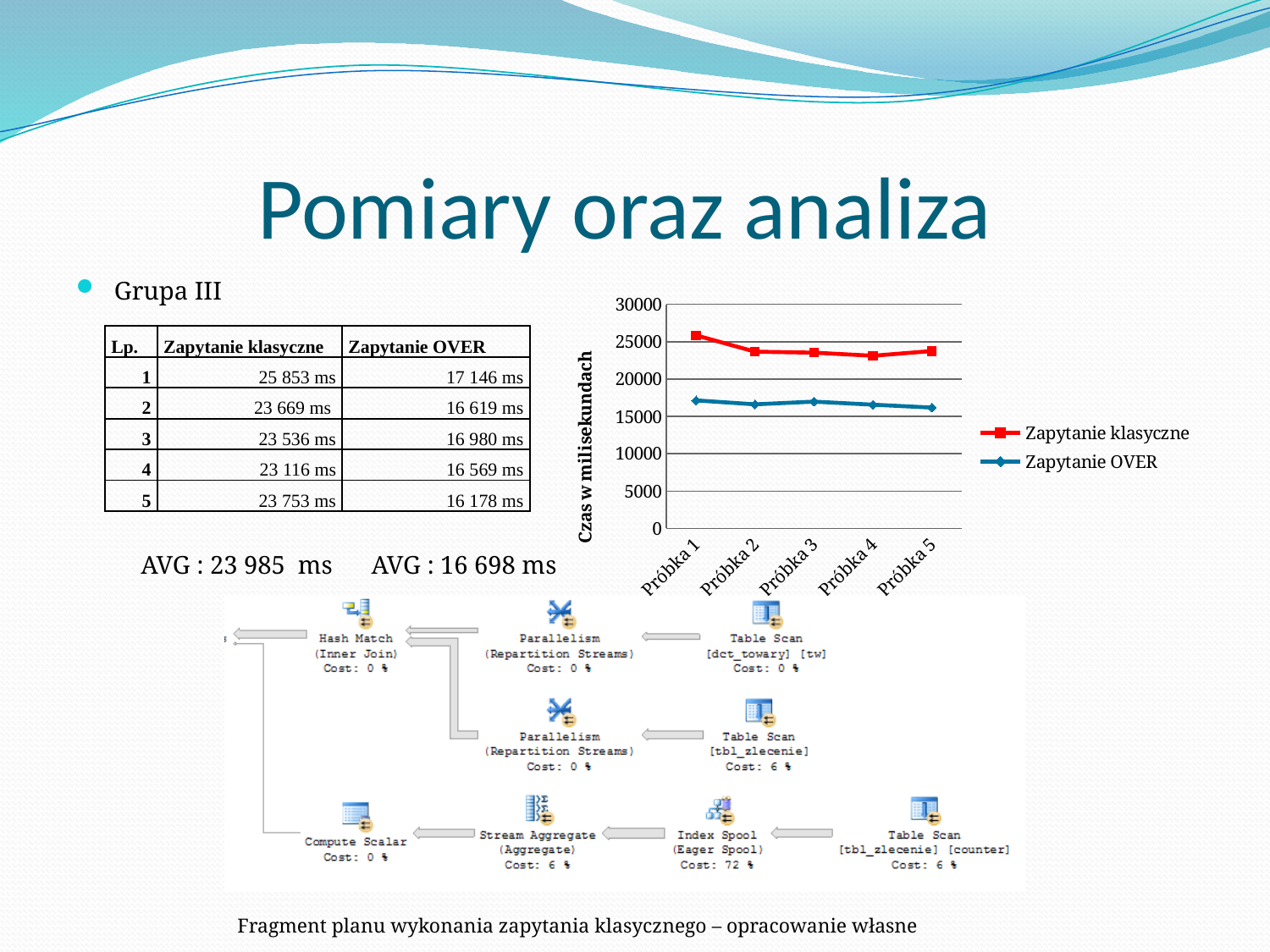
How many samples (Próbka) are plotted along the x axis of the chart? 5 Which series is drawn in red on the chart? Zapytanie klasyczne Is the value of Zapytanie OVER for Próbka 3 greater or less than 20000? less How many series does the chart legend list? 2 Is the value of Zapytanie klasyczne for Próbka 1 greater or less than 25000? greater What is the label of the chart's vertical axis? Czas w milisekundach What kind of chart is shown on the slide? line chart Does the Zapytanie klasyczne line rise or fall from Próbka 1 to Próbka 2? fall According to the table on the slide, what is the value of Zapytanie OVER for sample 5? 16 178 ms For which sample is the value of Zapytanie klasyczne highest? Próbka 1 According to the table on the slide, what is the value of Zapytanie klasyczne for sample 1? 25 853 ms Which series has the larger value for Próbka 4, Zapytanie klasyczne or Zapytanie OVER? Zapytanie klasyczne